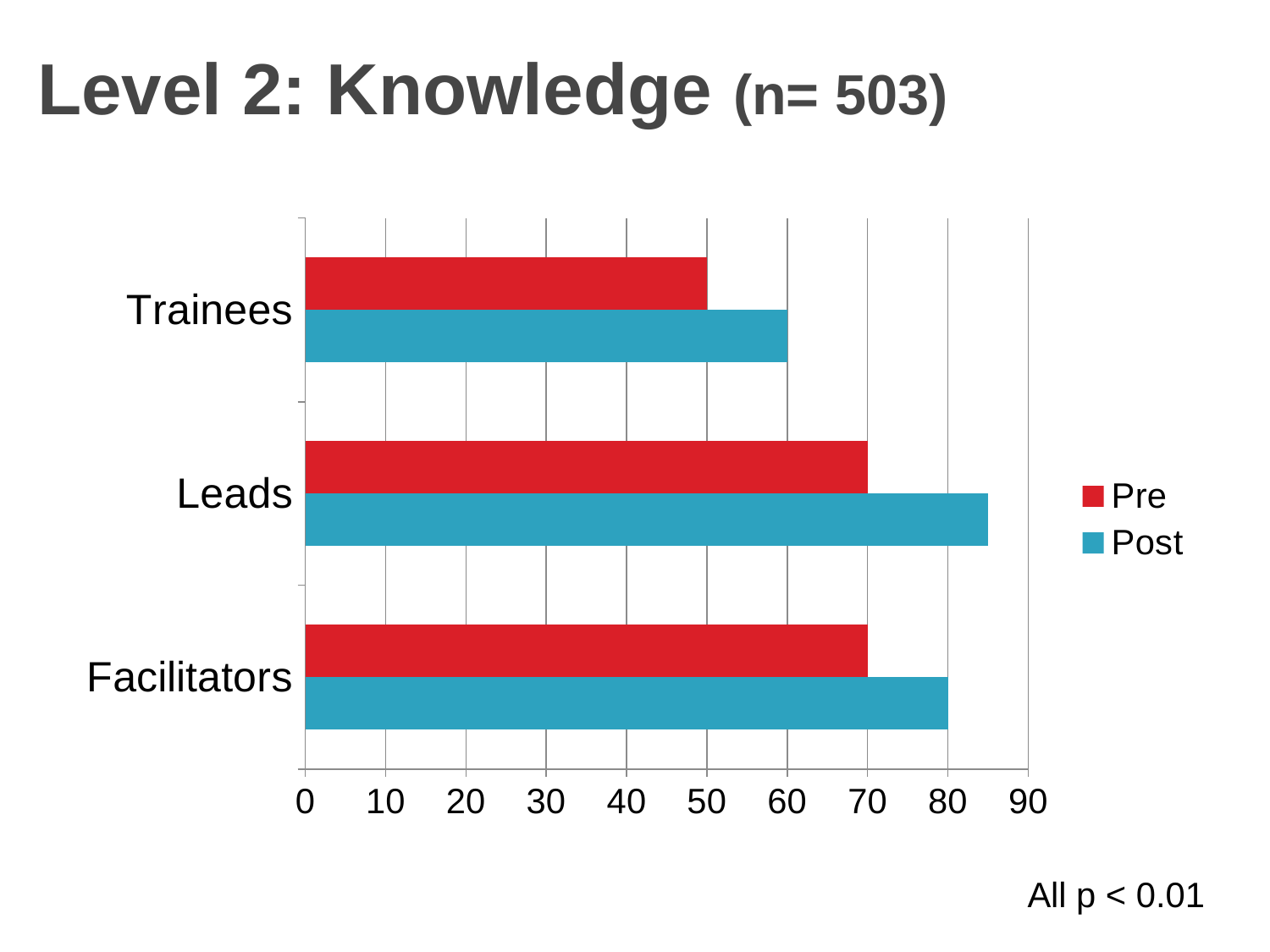
What is the Pre value for Trainees? 50 Which category has the lowest Pre value? Trainees What is the Post value for Trainees? 60 Which series is shown in red in the legend? Pre What is the difference between the Post and Pre values for Trainees? 10 What kind of chart is shown on the slide? bar chart What is the Pre value for Leads? 70 What is the Post value for Facilitators? 80 How many series does the legend list? 2 Which category has the highest Post value? Leads Is the Post value for Leads greater or less than 80? greater How many categories are shown on the chart? 3